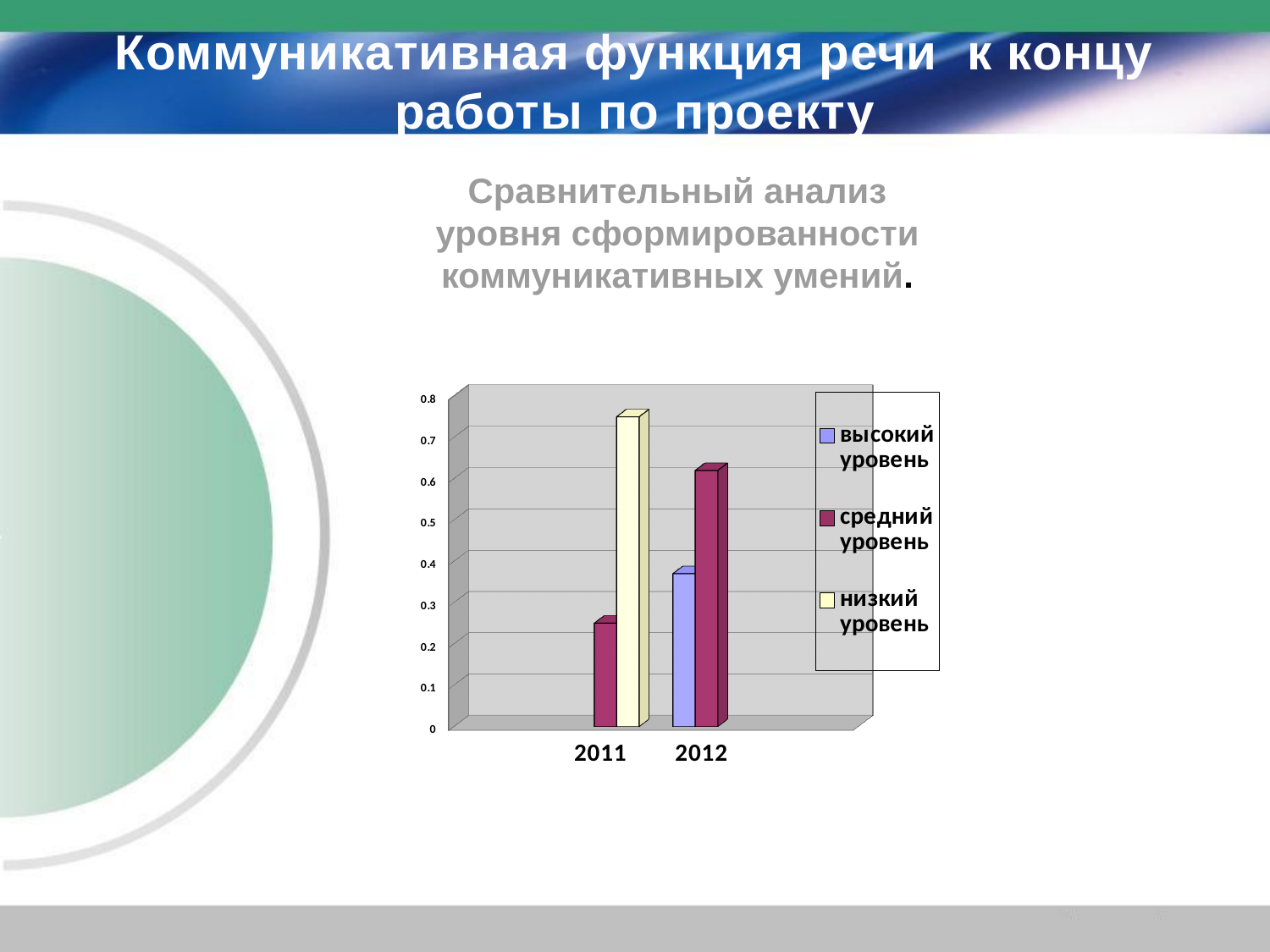
How many series does the chart legend list? 3 How many categories are shown on the x axis of the chart? 2 Which series has the tallest bar for 2011? низкий уровень What kind of chart is shown on the slide? bar chart Is the value for высокий уровень in 2012 greater or less than 0.3? greater Which series has the tallest bar for 2012? средний уровень Does the value for средний уровень rise or fall from 2011 to 2012? rise What colour represents низкий уровень in the chart legend? yellow Is the value for средний уровень in 2012 greater or less than 0.7? less Is the value for средний уровень in 2011 greater or less than 0.3? less Which is larger: низкий уровень in 2011 or средний уровень in 2012? низкий уровень in 2011